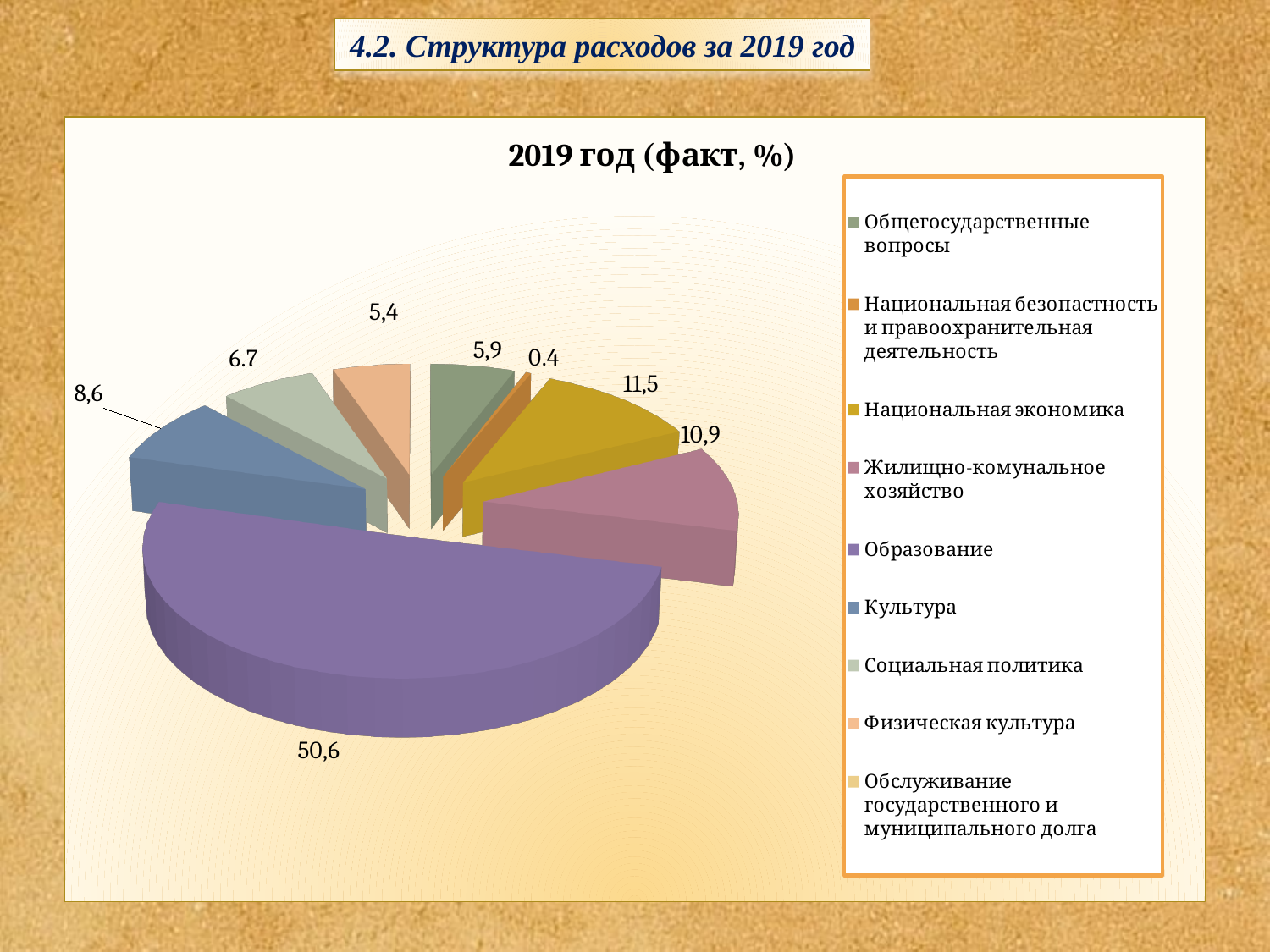
What is the value for Общегосударственные вопросы? 5,9 What is the title of the chart? 2019 год (факт, %) What is the value for Жилищно-коммунальное хозяйство? 10,9 What is the difference between the values for Образование and Жилищно-коммунальное хозяйство? 39,7 What kind of chart is shown on the slide? pie chart Which category has the largest share of the pie? Образование What is the value for Образование? 50,6 Which labelled category has the smallest share of the pie? Национальная безопастность и правоохранительная деятельность What is the value for Культура? 8,6 What is the value for Национальная экономика? 11,5 Which is larger, the value for Культура or the value for Социальная политика? Культура How many categories does the legend list? 9